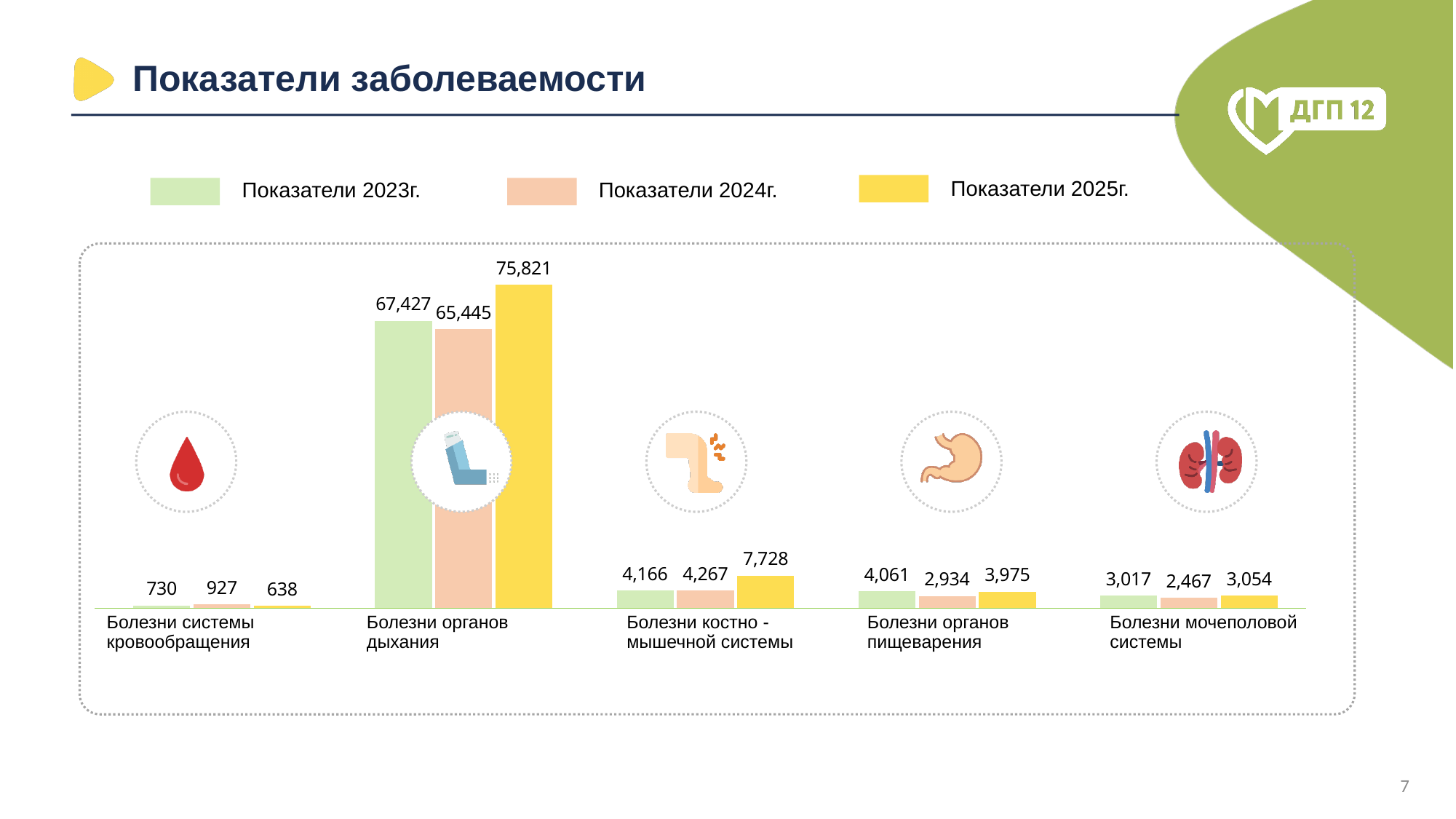
What is the value for Болезни органов дыхания in the Показатели 2025г. series? 75,821 For Болезни органов пищеварения, which is larger: the Показатели 2023г. value or the Показатели 2025г. value? Показатели 2023г. What is the value for Болезни системы кровообращения in the Показатели 2024г. series? 927 How many categories are shown on the chart? 5 What is the difference between the Показатели 2025г. and Показатели 2024г. values for Болезни органов дыхания? 10,376 Which category has the lowest value in the Показатели 2023г. series? Болезни системы кровообращения Which category has the highest value in the Показатели 2025г. series? Болезни органов дыхания What is the value for Болезни мочеполовой системы in the Показатели 2024г. series? 2,467 What kind of chart is shown on the slide? Bar chart How many series does the legend list? 3 What is the value for Болезни костно-мышечной системы in the Показатели 2023г. series? 4,166 What is the difference between the Показатели 2025г. and Показатели 2023г. values for Болезни костно-мышечной системы? 3,562